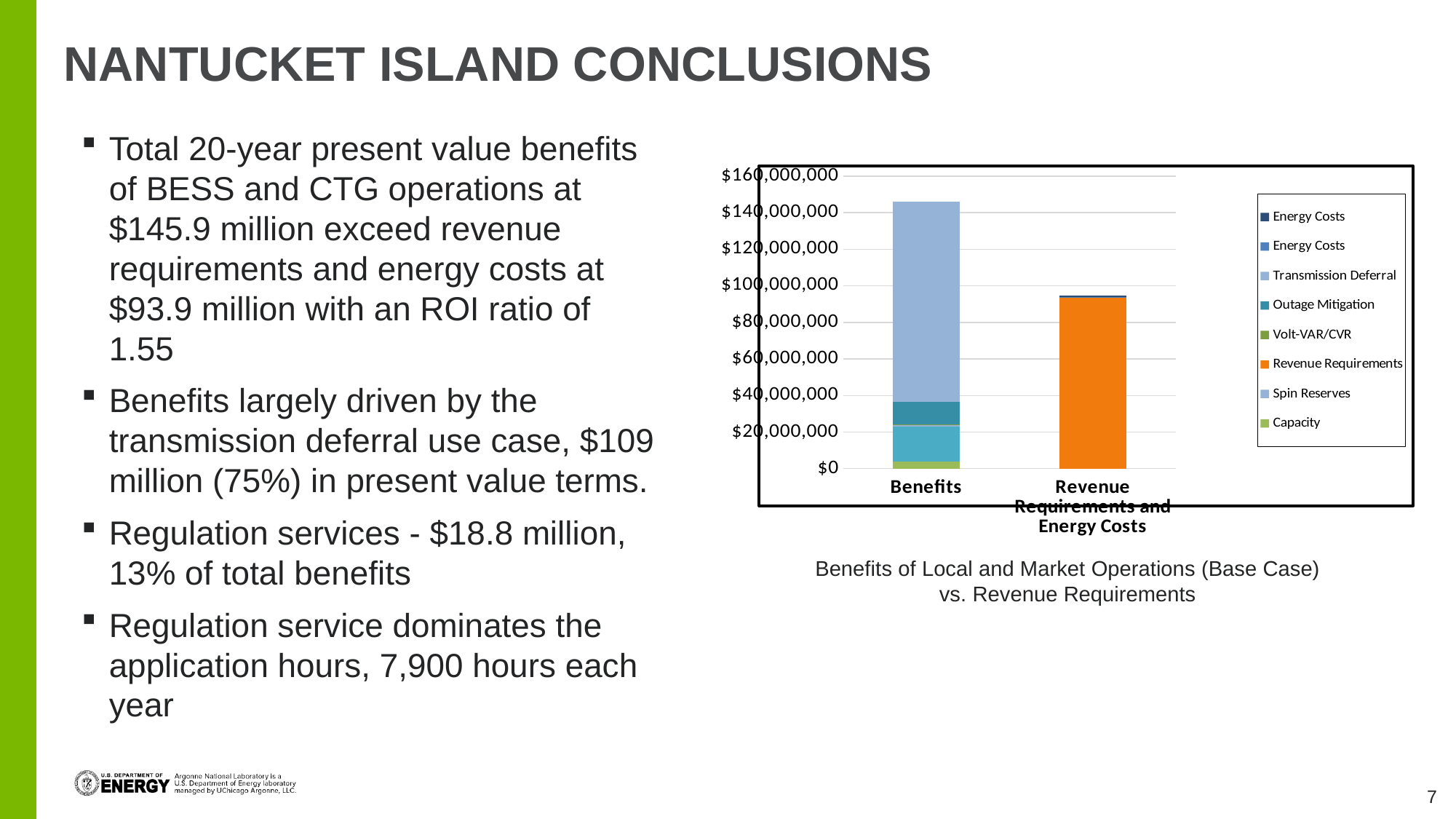
Is the total value of the Revenue Requirements and Energy Costs bar greater or less than $80,000,000? greater What is the caption (title) given below the chart? Benefits of Local and Market Operations (Base Case) vs. Revenue Requirements Is the total value of the Revenue Requirements and Energy Costs bar greater or less than $100,000,000? less What kind of chart is shown on the slide? Stacked bar chart How many entries does the chart's legend list? 8 Which category has the lowest total bar in the chart? Revenue Requirements and Energy Costs Is the total value of the Benefits bar greater or less than $140,000,000? greater Which legend series makes up the largest segment of the Benefits bar? Transmission Deferral Which category has the highest total bar in the chart? Benefits Which bar is taller, Benefits or Revenue Requirements and Energy Costs? Benefits How many bars (categories) are plotted on the x axis of the chart? 2